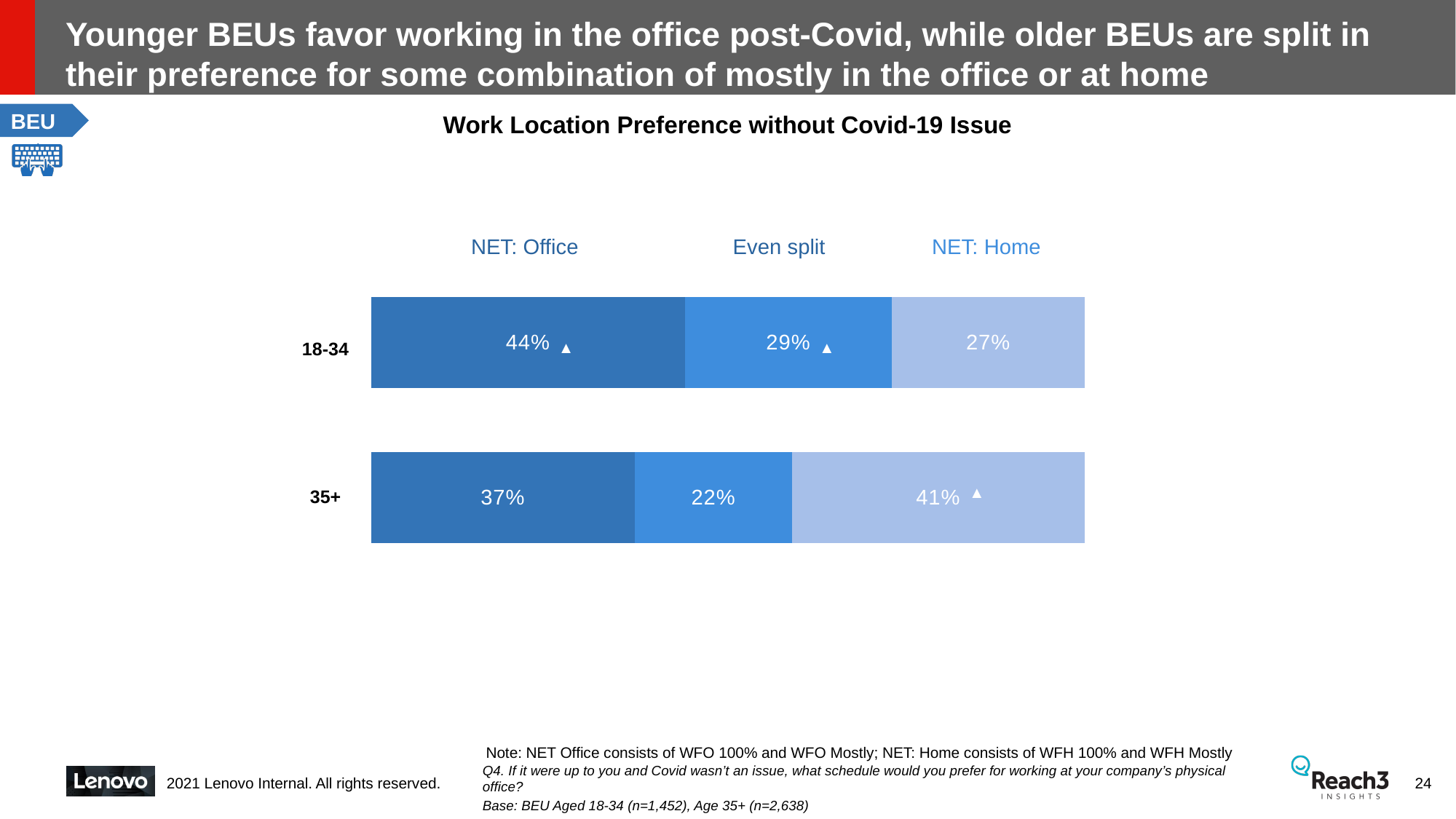
What is the NET: Home value for the 18-34 group? 27% What percentage of the 18-34 group falls under NET: Office? 44% What percentage of the 35+ group falls under NET: Home? 41% Which segment is the largest for the 35+ group? NET: Home What is the Even split value for the 35+ group? 22% What type of chart is shown on the slide? Stacked bar chart Which segment is the smallest for the 18-34 group? NET: Home How many series does the chart show? 3 Which age group has the higher NET: Home value? 35+ What is the difference between the Even split values for 18-34 and 35+? 7 percentage points Which age group has the higher NET: Office value? 18-34 What is the difference between the NET: Home values for 35+ and 18-34? 14 percentage points